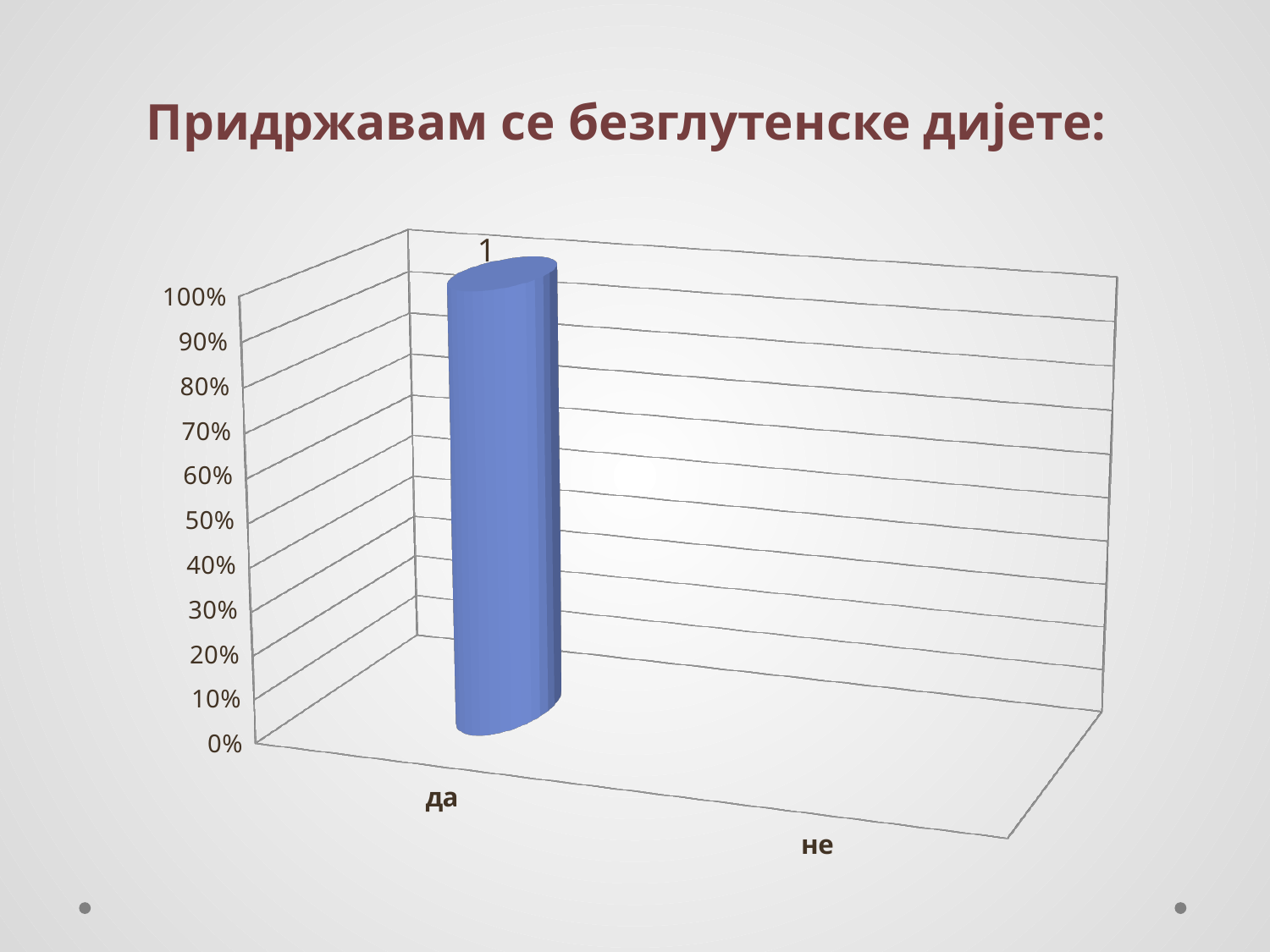
Is the value for "да" greater or less than 50%? greater What kind of chart is shown on the slide? bar chart What is the highest value shown on the vertical axis? 100% What is the title of the slide? Придржавам се безглутенске дијете: Do the values rise or fall from "да" to "не"? fall Which category has the lowest value? не Which is larger, the value for "да" or the value for "не"? да What data label is shown on the bar for "да"? 1 How many categories are shown on the x axis? 2 Is the value for "не" greater or less than 10%? less Which category has the highest value? да